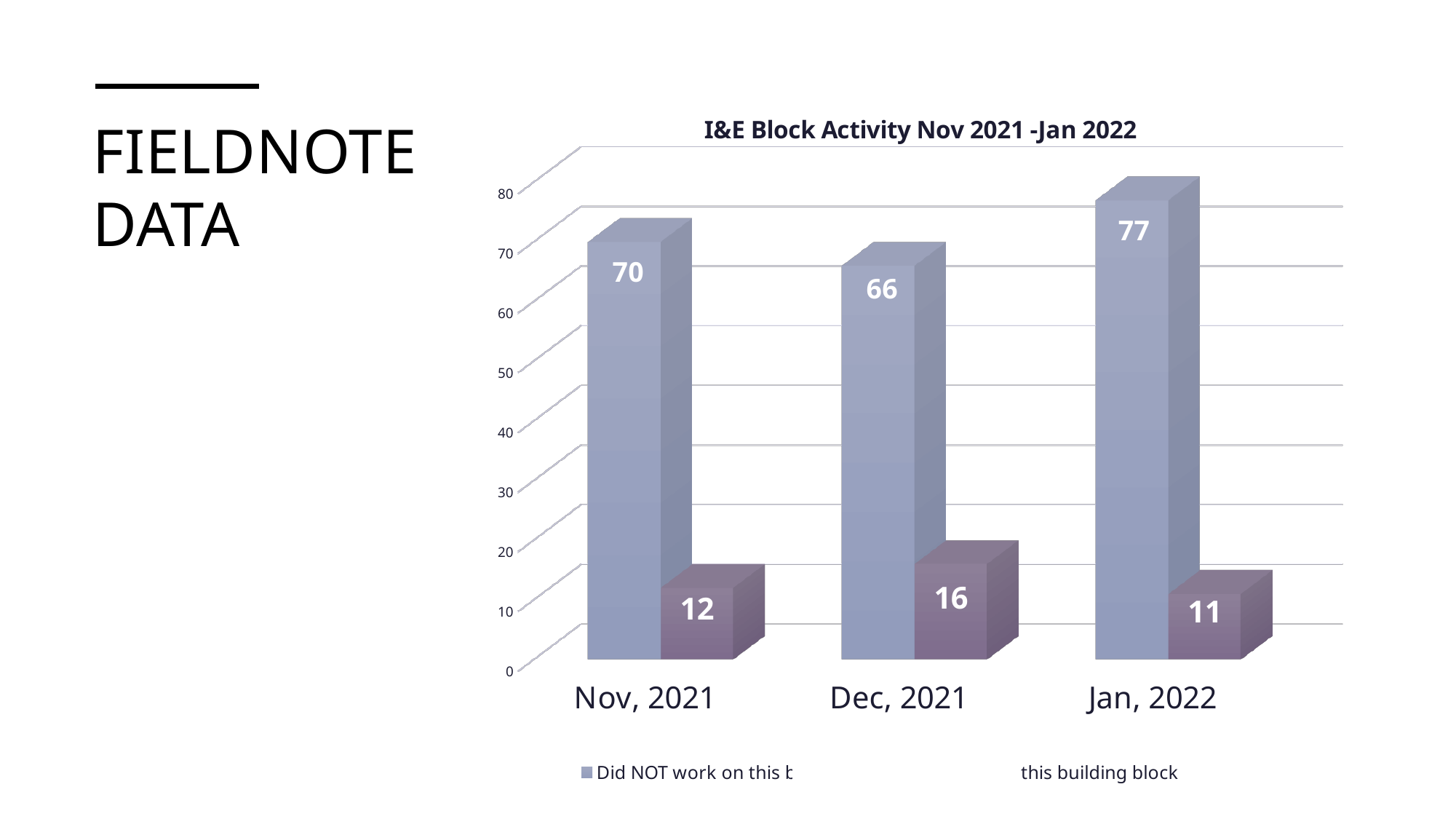
What is the title of the chart? I&E Block Activity Nov 2021 -Jan 2022 What is the value of the purple bar for Dec, 2021? 16 How many months are shown on the x axis? 3 What is the value of the blue-grey bar for Jan, 2022? 77 What is the value of the purple bar for Jan, 2022? 11 What is the difference between the blue-grey bar values for Jan, 2022 and Dec, 2021? 11 Which month has the highest value for the blue-grey series? Jan, 2022 What is the value of the blue-grey bar for Nov, 2021? 70 What is the difference between the blue-grey and purple bars for Nov, 2021? 58 Which is larger, the purple bar for Dec, 2021 or the purple bar for Nov, 2021? Dec, 2021 What kind of chart is shown on the slide? Bar chart Which month has the lowest value for the purple series? Jan, 2022